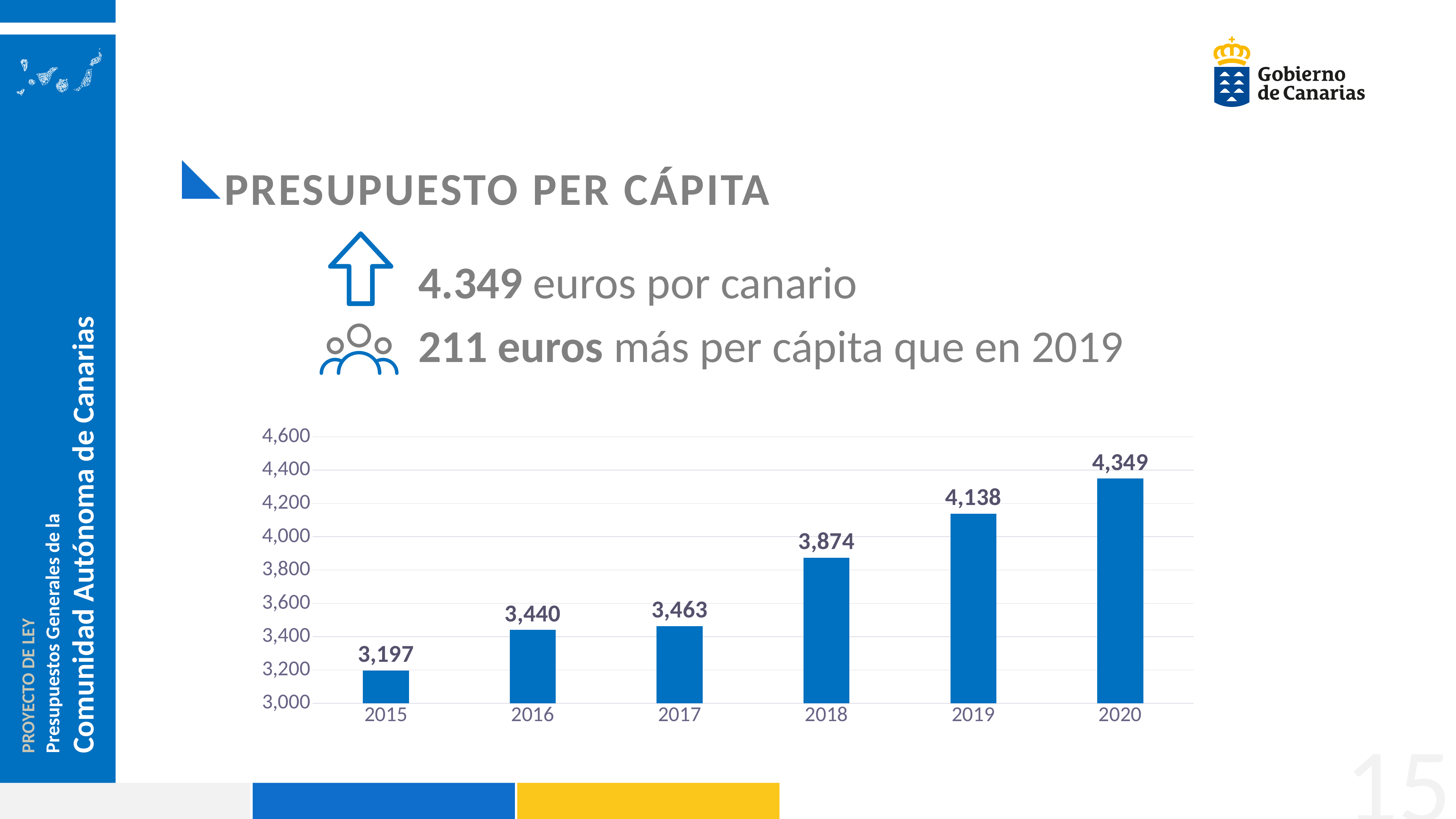
Which year has the highest value? 2020 Which is larger, the value for 2016 or the value for 2019? 2019 Is the value for 2019 greater or less than 4,000? greater Which year has the lowest value? 2015 Do the values rise or fall from 2015 to 2020? rise How many years are shown on the x axis? 6 What is the value for 2020? 4,349 What is the value for 2018? 3,874 What kind of chart is shown on the slide? bar chart What is the difference between the values for 2018 and 2017? 411 What is the difference between the values for 2020 and 2019? 211 What is the value for 2015? 3,197